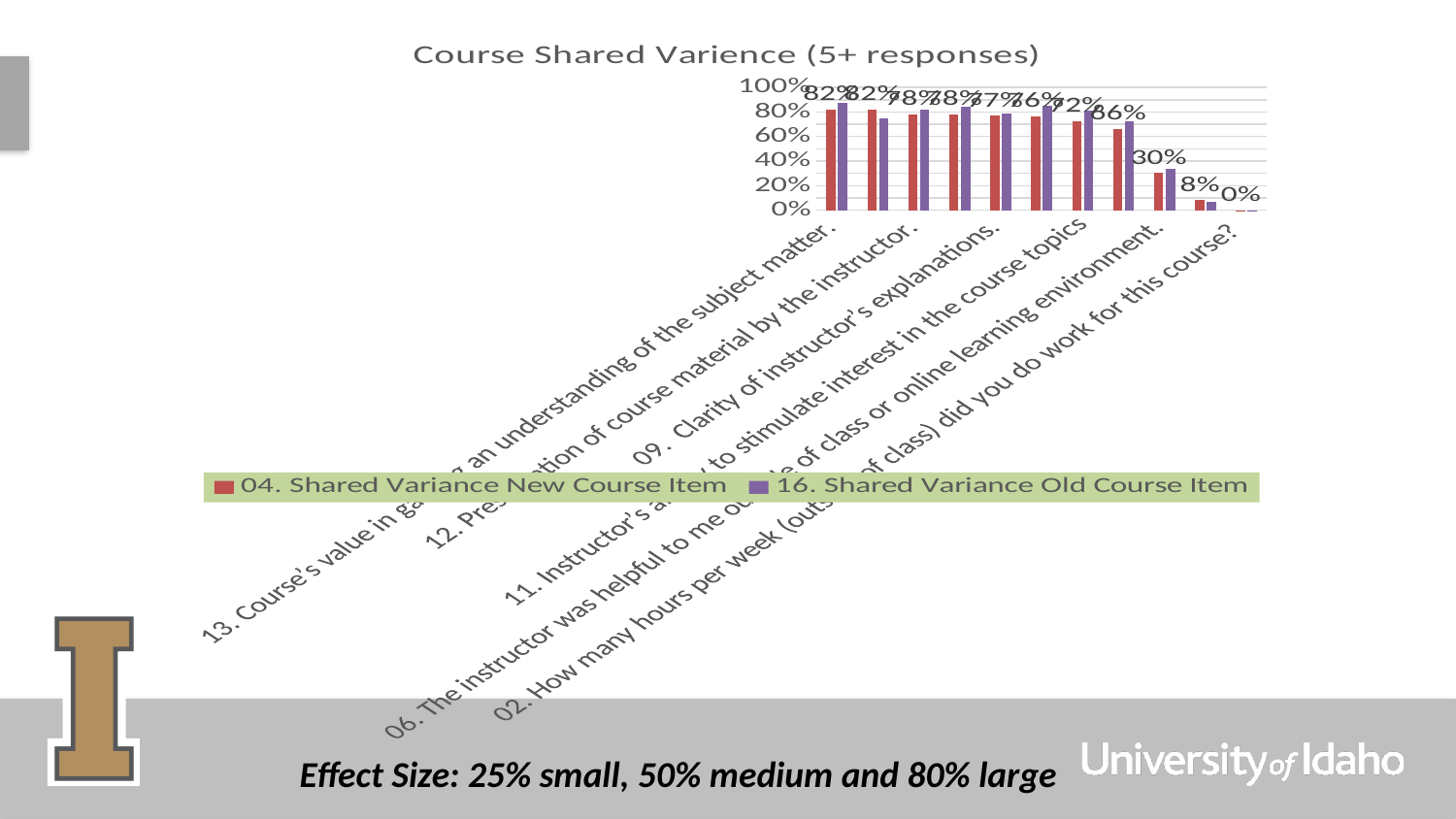
What are the two series named in the chart legend? 04. Shared Variance New Course Item; 16. Shared Variance Old Course Item How many series does the legend of the chart list? 2 Is the Shared Variance New Course Item value for "02. How many hours per week (outside of class) did you do work for this course?" greater or less than 20%? less Is the Shared Variance New Course Item value for "13. Course's value in gaining an understanding of the subject matter." greater or less than 60%? greater What is the title of the chart? Course Shared Varience (5+ responses) Which category has the lowest shared variance values in the chart? 02. How many hours per week (outside of class) did you do work for this course? What kind of chart is shown on the slide? bar chart Which category has the larger shared variance: "13. Course's value in gaining an understanding of the subject matter." or "02. How many hours per week (outside of class) did you do work for this course?" 13. Course's value in gaining an understanding of the subject matter. Do the values in the chart generally rise or fall moving from left to right along the x axis? fall What is the Shared Variance New Course Item value for the first category, "13. Course's value in gaining an understanding of the subject matter."? 82% Is the Shared Variance Old Course Item value for "09. Clarity of instructor's explanations." greater or less than 60%? greater